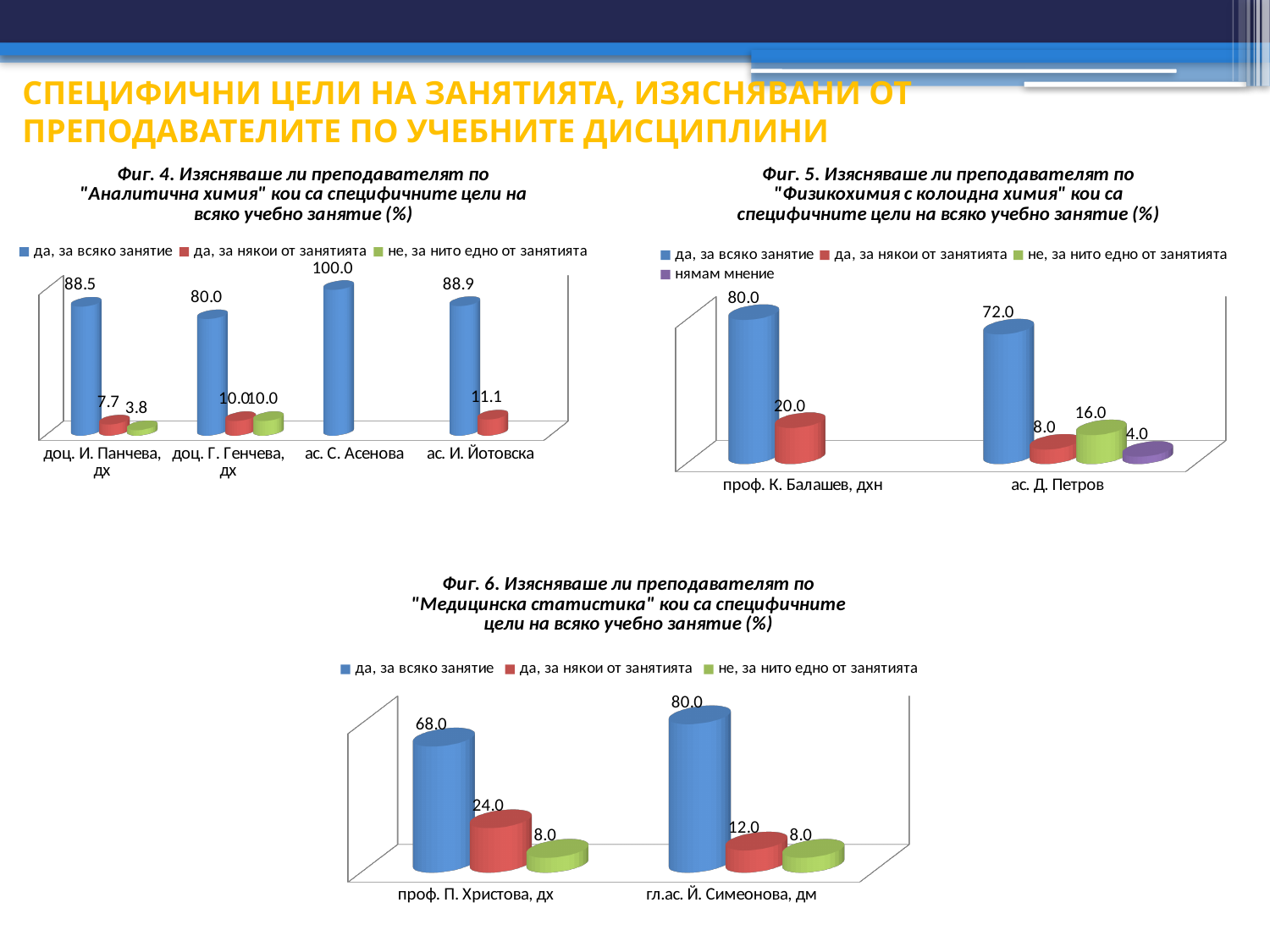
In Fig. 5 (Физикохимия с колоидна химия), how many series does the legend list? 4 In Fig. 5 (Физикохимия с колоидна химия), what is the value of "да, за някои от занятията" for проф. К. Балашев, дхн? 20.0 In Fig. 5 (Физикохимия с колоидна химия), what is the difference between the "да, за всяко занятие" values for проф. К. Балашев, дхн and ас. Д. Петров? 8.0 In Fig. 6 (Медицинска статистика), what is the difference between the "да, за някои от занятията" values for проф. П. Христова, дх and гл.ас. Й. Симеонова, дм? 12.0 In Fig. 5 (Физикохимия с колоидна химия), what is the value of "нямам мнение" for ас. Д. Петров? 4.0 In Fig. 4 (Аналитична химия), which lecturer has the highest value for "да, за всяко занятие"? ас. С. Асенова In Fig. 4 (Аналитична химия), what is the value of "да, за всяко занятие" for ас. С. Асенова? 100.0 What type of chart is Fig. 6 (Медицинска статистика)? Bar chart In Fig. 6 (Медицинска статистика), what is the value of "да, за някои от занятията" for проф. П. Христова, дх? 24.0 In Fig. 6 (Медицинска статистика), which lecturer has the higher value for "да, за всяко занятие"? гл.ас. Й. Симеонова, дм In Fig. 4 (Аналитична химия), how many lecturers are shown on the x axis? 4 In Fig. 4 (Аналитична химия), what is the value of "не, за нито едно от занятията" for доц. И. Панчева, дх? 3.8